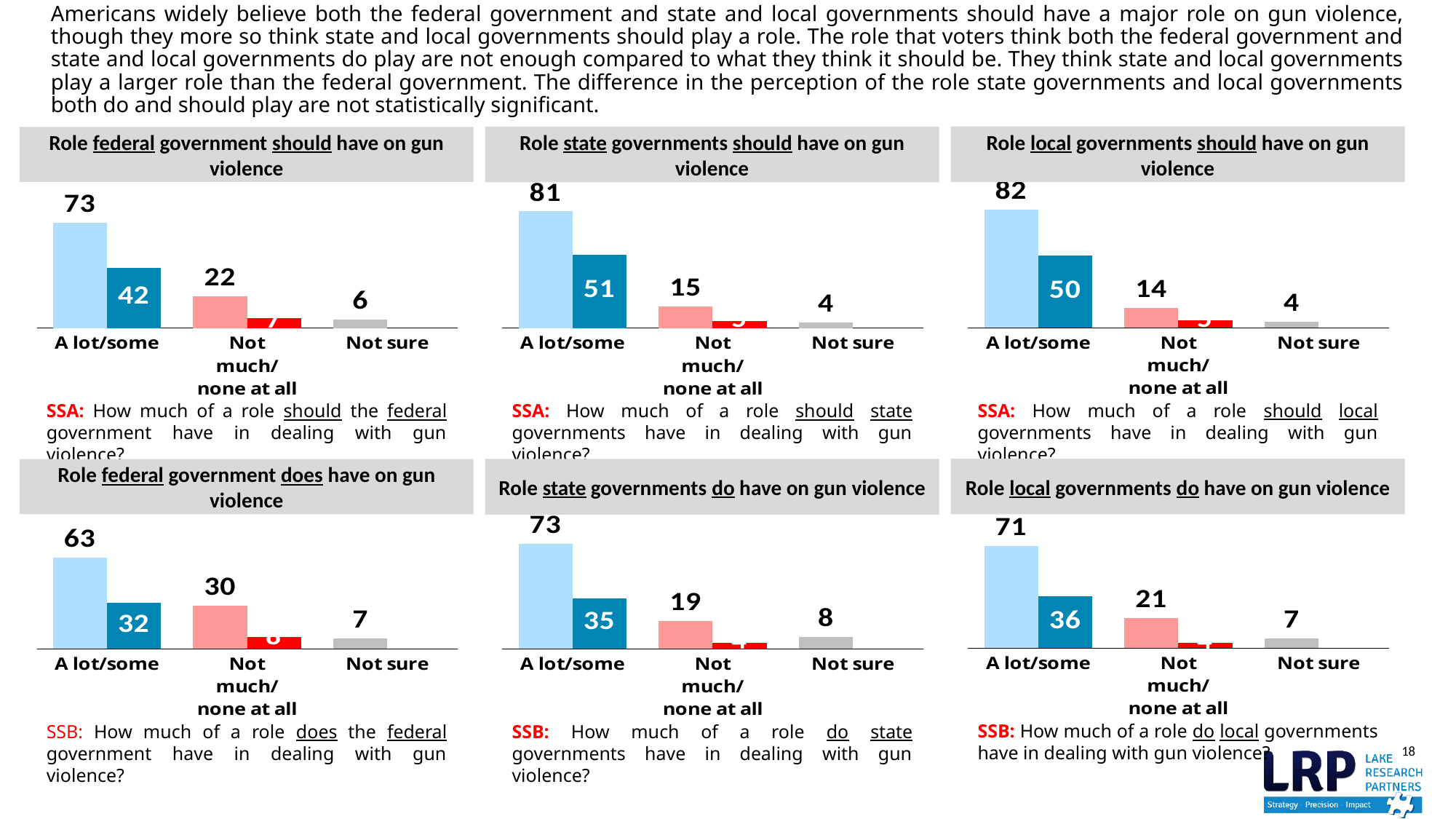
In the chart 'Role federal government does have on gun violence', which category has the highest value? A lot/some How many charts are shown on the slide? 6 In the chart 'Role state governments should have on gun violence', what value is printed on the dark blue bar for 'A lot/some'? 51 Which is larger: the 'A lot/some' value in 'Role state governments should have on gun violence' or in 'Role local governments should have on gun violence'? Role local governments should have on gun violence What type of chart is 'Role state governments do have on gun violence'? Bar chart In the chart 'Role federal government should have on gun violence', what is the value of the tallest bar for 'A lot/some'? 73 In the chart 'Role state governments should have on gun violence', which category has the lowest value? Not sure In the chart 'Role local governments do have on gun violence', what is the value labeled for 'Not much/none at all'? 21 What is the difference between the 'A lot/some' value in 'Role local governments should have on gun violence' (82) and in 'Role local governments do have on gun violence' (71)? 11 How many categories are shown on the x axis of the chart 'Role federal government should have on gun violence'? 3 What is the difference between the 'A lot/some' value in 'Role federal government should have on gun violence' (73) and the 'A lot/some' value in 'Role federal government does have on gun violence' (63)? 10 In the chart 'Role state governments do have on gun violence', what is the value for 'Not sure'? 8